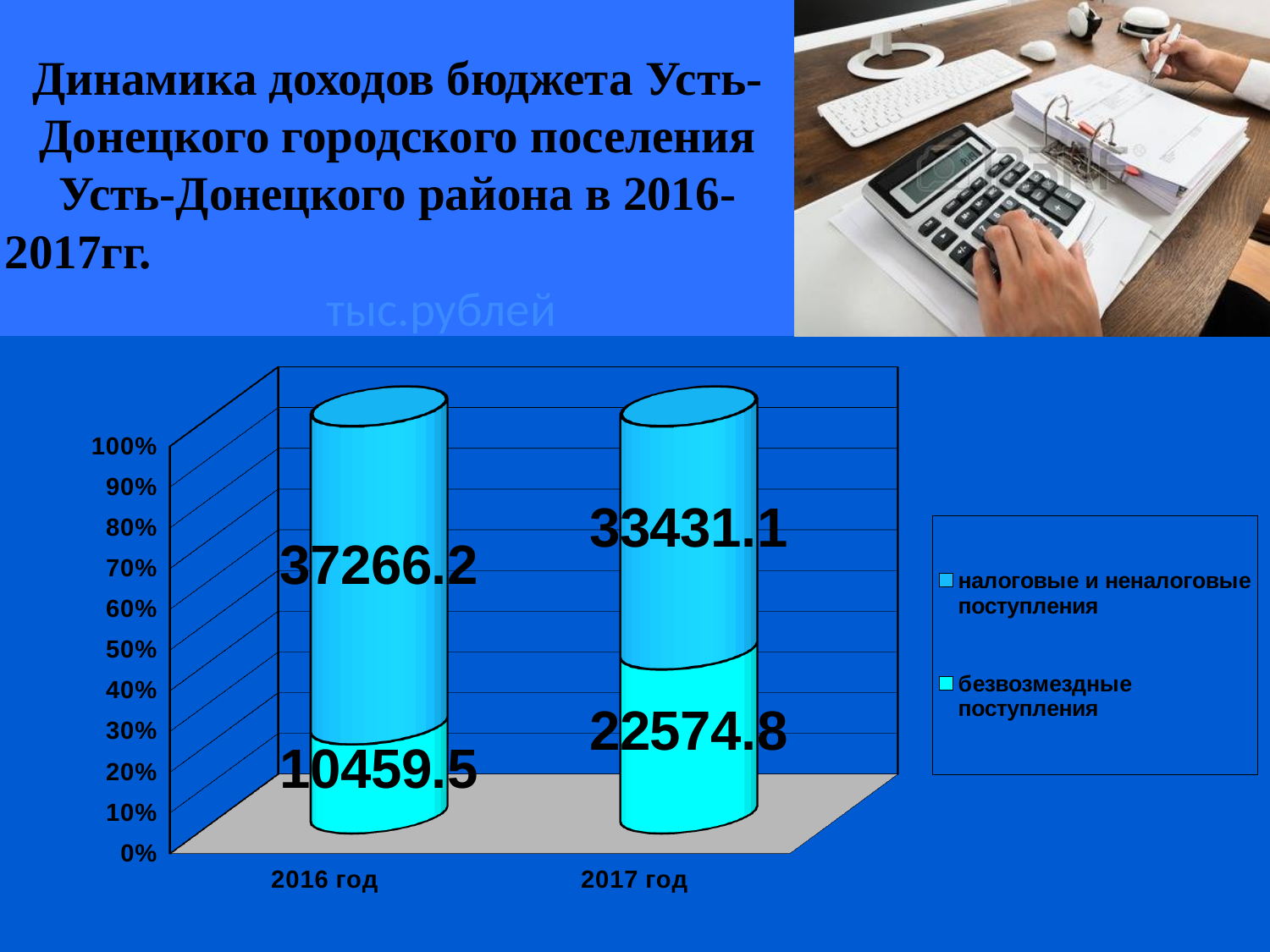
Is the share of безвозмездные поступления in the 2017 год bar greater or less than 30%? greater What is the value for налоговые и неналоговые поступления in 2017 год? 33431.1 What is the difference between the налоговые и неналоговые поступления values for 2016 год and 2017 год? 3835.1 By how much did безвозмездные поступления increase from 2016 год to 2017 год? 12115.3 How many series does the legend list? 2 What is the value for безвозмездные поступления in 2016 год? 10459.5 What is the value for безвозмездные поступления in 2017 год? 22574.8 What is the total of the two series for 2016 год? 47725.7 What is the total of the two series for 2017 год? 56005.9 What is the value for налоговые и неналоговые поступления in 2016 год? 37266.2 In which year is the value for безвозмездные поступления higher? 2017 год Which year has the higher value for налоговые и неналоговые поступления? 2016 год